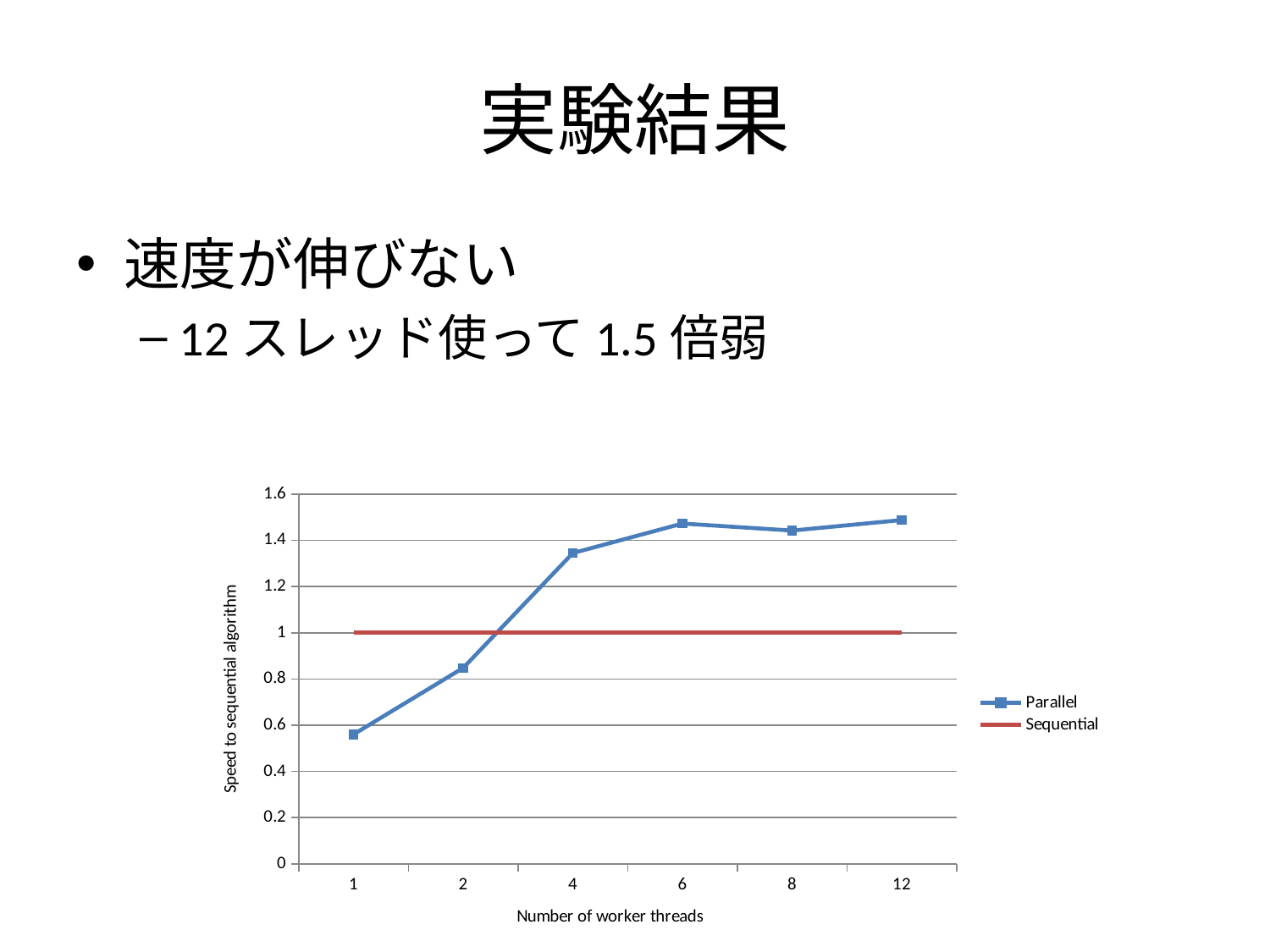
Is the Parallel value for 1 worker thread greater or less than 0.6? less At which number of worker threads is the Parallel series lowest? 1 What is the label of the y axis? Speed to sequential algorithm How many worker-thread counts are plotted along the x axis? 6 What is the value of the Sequential series across all thread counts? 1 Is the Parallel value for 4 worker threads greater or less than 1.2? greater How many series does the legend list? 2 What kind of chart is shown on the slide? line chart Does the Parallel series generally rise or fall as the number of worker threads increases from 1 to 6? rise Which is larger for the Parallel series: the value at 2 worker threads or at 4 worker threads? 4 worker threads Is the Parallel value for 12 worker threads greater or less than 1.6? less